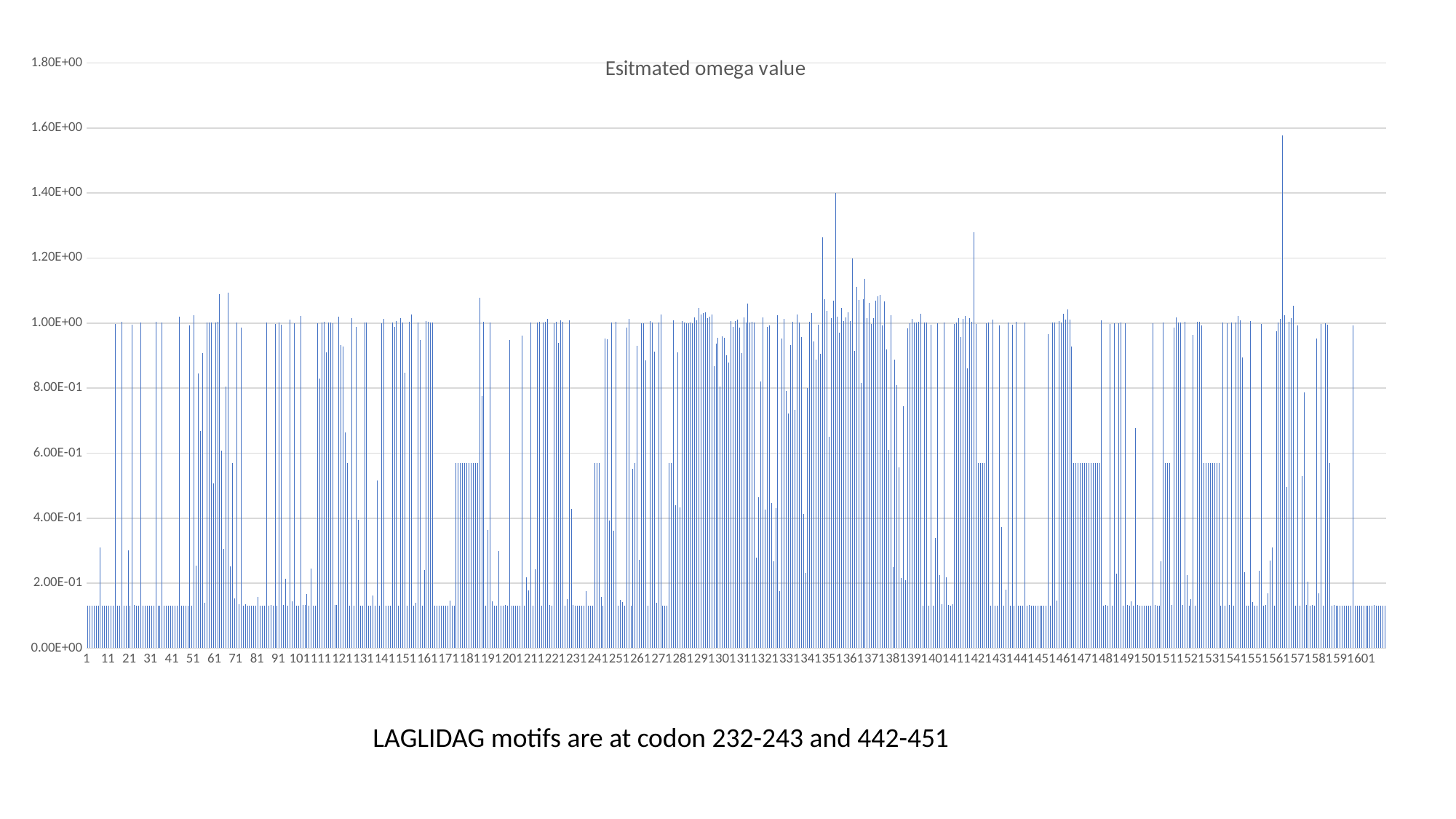
Is the tallest bar in the chart greater or less than 1.40E+00? greater What is the highest tick label shown on the y axis of the chart? 1.80E+00 What is the title of the chart? Esitmated omega value What kind of chart is shown on the slide? bar chart Is the value for category 1 greater or less than 2.00E-01? less Is the tallest bar in the chart greater or less than 1.20E+00? greater